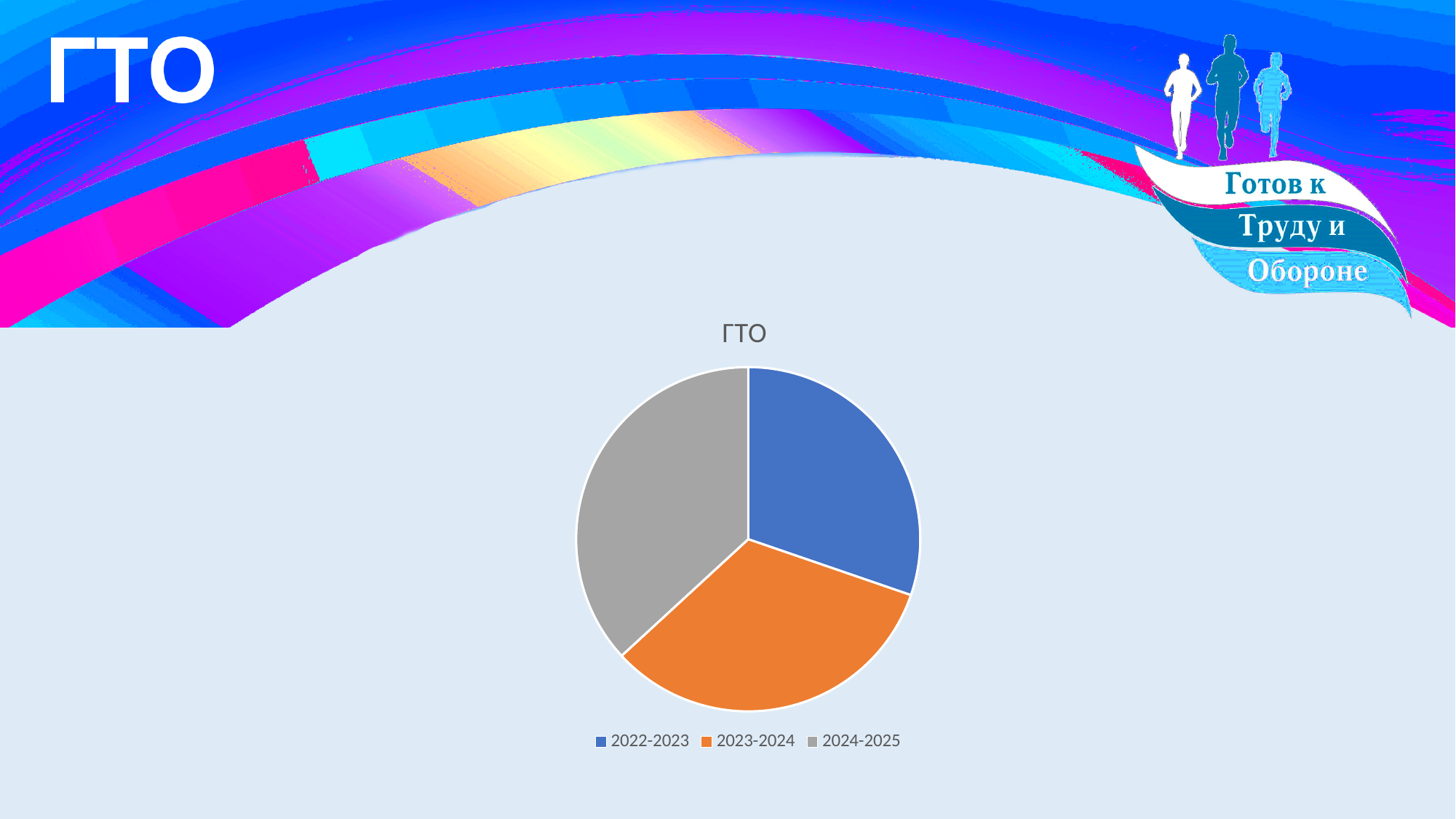
What is the title of the chart? ГТО Which category is shown in gray? 2024-2025 How many entries does the chart legend list? 3 What colour is the slice for 2023-2024? orange What kind of chart is shown on the slide? pie chart Which category has the largest slice of the pie? 2024-2025 How many slices does the pie chart have? 3 Which category has the smallest slice of the pie? 2022-2023 Which category is shown in blue? 2022-2023 Which slice is larger, 2022-2023 or 2024-2025? 2024-2025